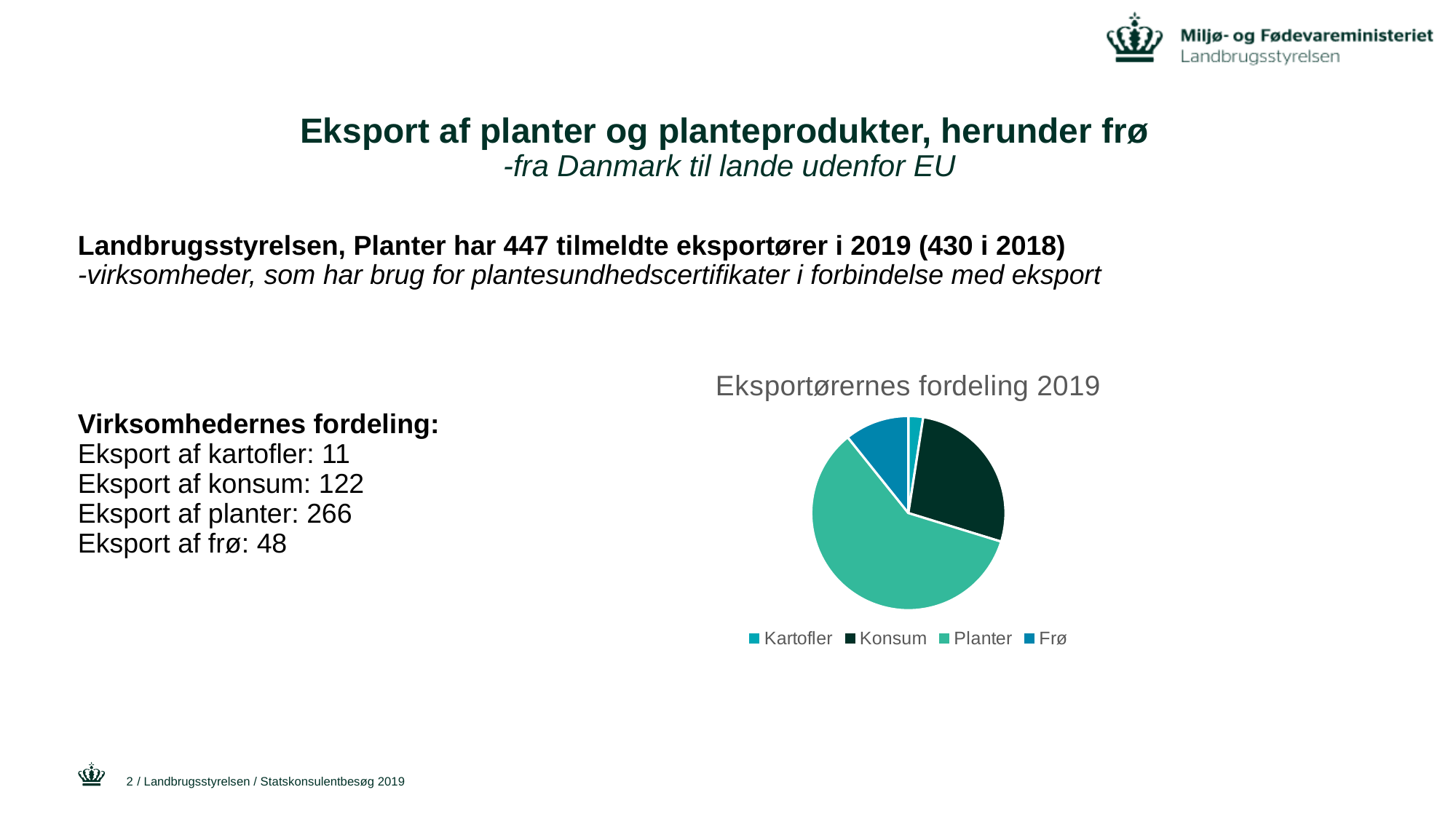
How many exporters does the Konsum slice of the pie chart represent, according to the slide? 122 Which slice is larger in the pie chart, Planter or Konsum? Planter Which category has the smallest slice in the pie chart? Kartofler What kind of chart is shown on the slide? Pie chart What is the difference between the Planter and Konsum values shown on the slide? 144 How many exporters does the Frø slice of the pie chart represent, according to the slide? 48 What is the title of the pie chart? Eksportørernes fordeling 2019 How many exporters does the Planter slice of the pie chart represent, according to the slide? 266 How many exporters does the Kartofler slice of the pie chart represent, according to the slide? 11 Which slice is larger in the pie chart, Konsum or Frø? Konsum How many slices does the pie chart have? 4 Which category has the largest slice in the pie chart? Planter